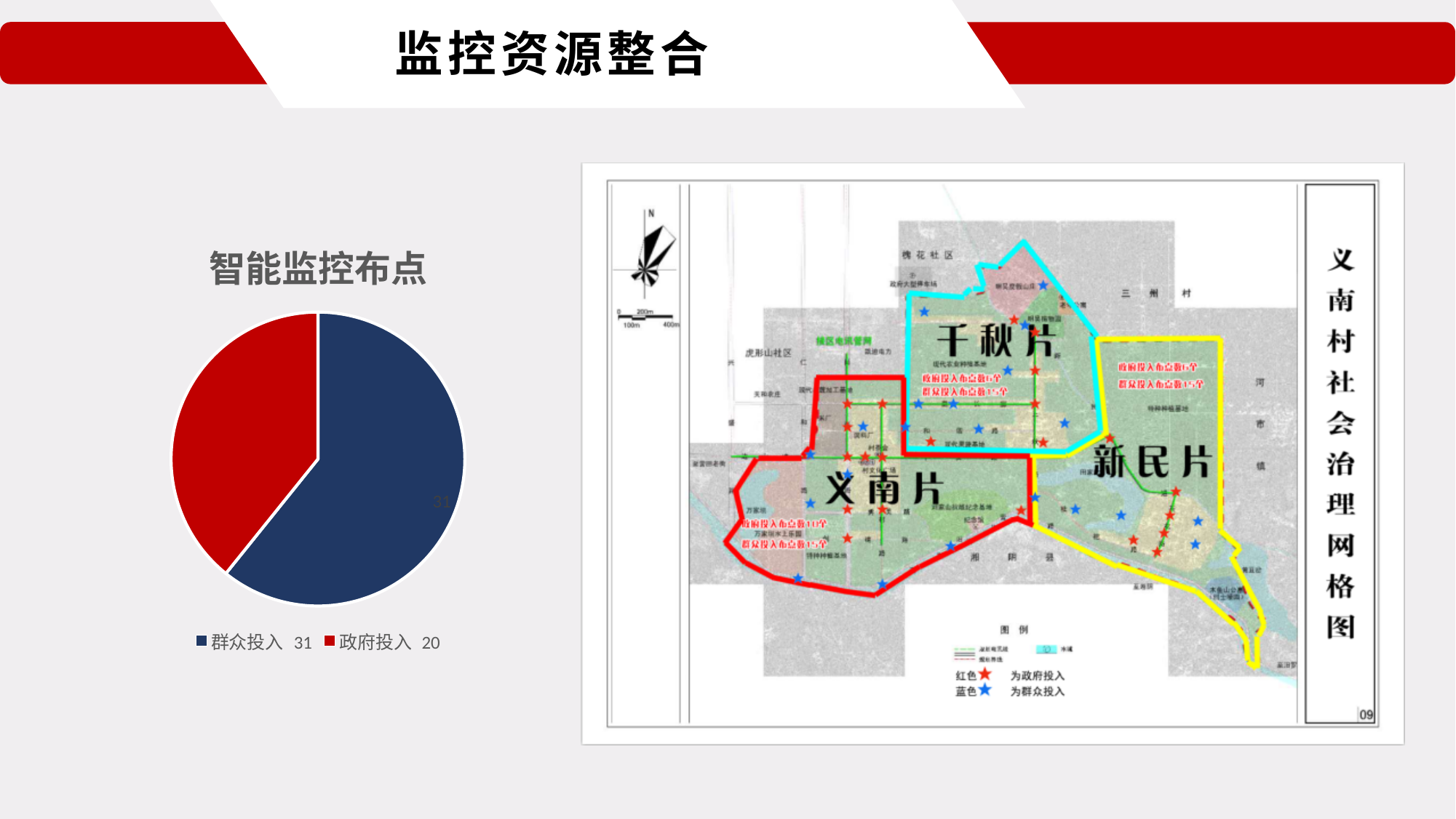
Which is larger, 群众投入 or 政府投入? 群众投入 What is the title of the pie chart? 智能监控布点 What is the difference between the values for 群众投入 and 政府投入? 11 Which category has the smallest slice in the pie chart? 政府投入 What is the total of the two values in the pie chart? 51 Which category has the largest slice in the pie chart? 群众投入 How many slices does the pie chart have? 2 What is the value for 群众投入 in the pie chart? 31 How many entries does the legend of the pie chart list? 2 What colour is the 政府投入 slice in the pie chart? Red What is the value for 政府投入 in the pie chart? 20 What kind of chart is shown on the left of the slide? Pie chart